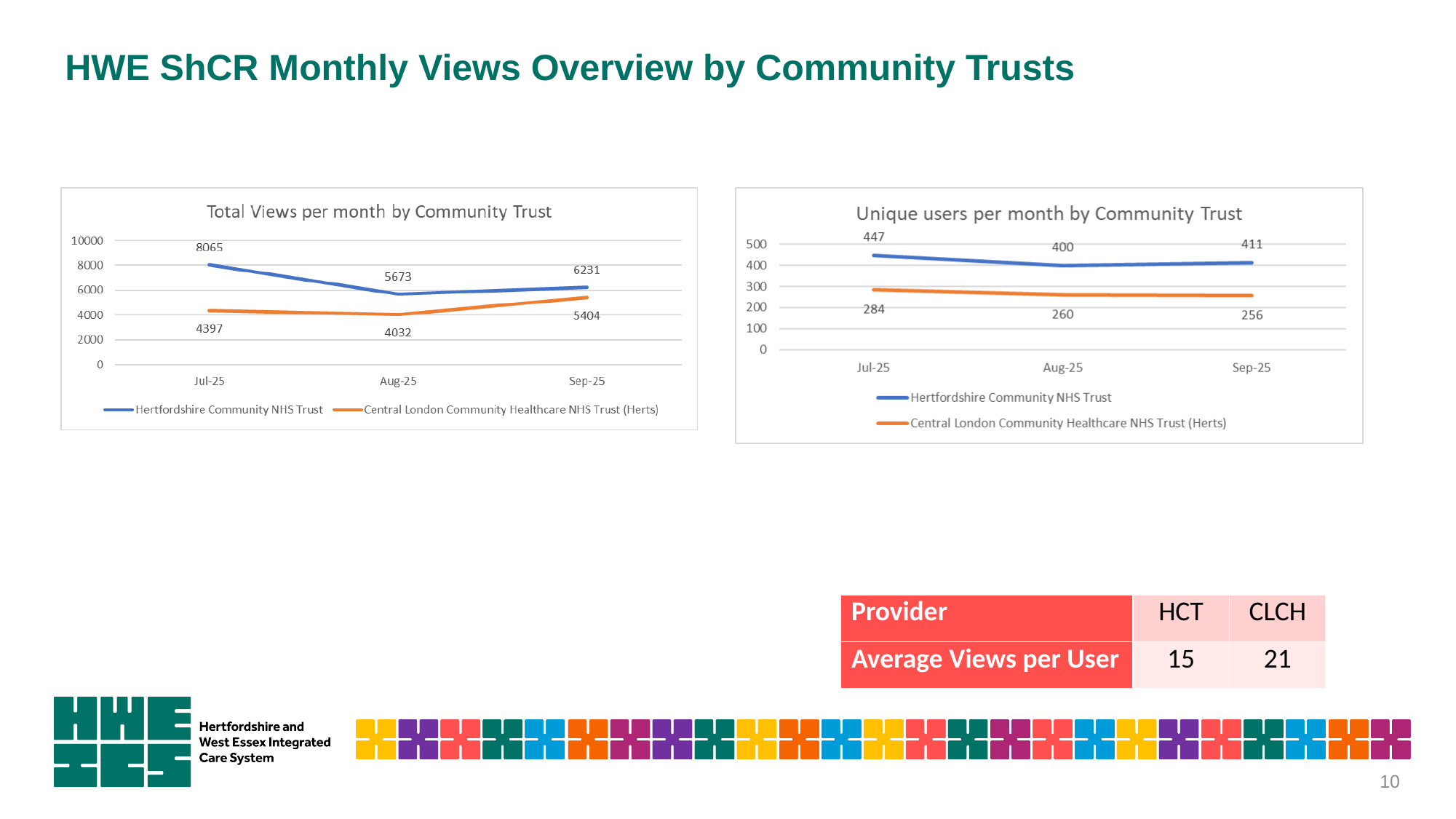
In the 'Total Views per month by Community Trust' chart, what is the difference between the two trusts' values in Sep-25? 827 In the 'Unique users per month by Community Trust' chart, what is the difference between the Hertfordshire Community NHS Trust values in Jul-25 and Aug-25? 47 In the 'Total Views per month by Community Trust' chart, what is the value for Central London Community Healthcare NHS Trust (Herts) in Aug-25? 4032 How many series does the legend of the 'Total Views per month by Community Trust' chart list? 2 In the 'Unique users per month by Community Trust' chart, which trust has the higher value in Aug-25? Hertfordshire Community NHS Trust In the 'Total Views per month by Community Trust' chart, what is the value for Hertfordshire Community NHS Trust in Jul-25? 8065 In the 'Unique users per month by Community Trust' chart, what is the value for Hertfordshire Community NHS Trust in Sep-25? 411 In the 'Total Views per month by Community Trust' chart, in which month is the Hertfordshire Community NHS Trust value lowest? Aug-25 In the 'Total Views per month by Community Trust' chart, does the Central London Community Healthcare NHS Trust (Herts) line rise or fall from Aug-25 to Sep-25? rise In the 'Unique users per month by Community Trust' chart, how many months are shown on the x axis? 3 What kind of chart is the 'Unique users per month by Community Trust' chart? line chart In the 'Unique users per month by Community Trust' chart, what is the value for Central London Community Healthcare NHS Trust (Herts) in Jul-25? 284